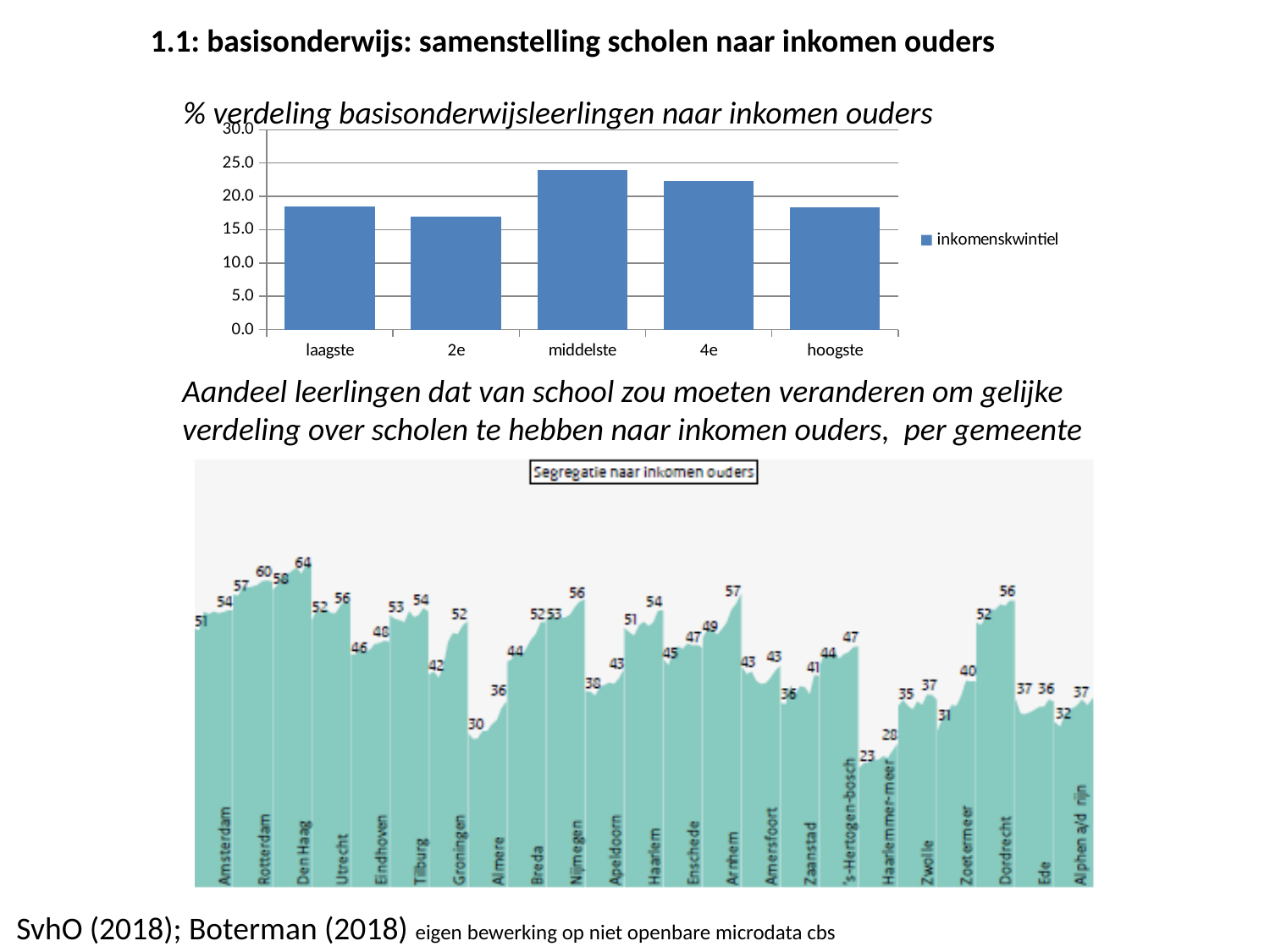
What is the legend entry of the top chart? inkomenskwintiel What kind of chart is the top chart on the slide? bar chart How many series does the legend of the top chart list? 1 In the top chart (% verdeling basisonderwijsleerlingen naar inkomen ouders), which category has the lowest value? 2e How many categories are shown on the x axis of the top chart? 5 In the top chart, which is larger, the value for middelste or the value for 4e? middelste In the top chart, is the value for 2e greater or less than 20.0? less In the top chart, is the value for middelste greater or less than 20.0? greater In the top chart, is the value for laagste greater or less than 15.0? greater In the bottom chart (Segregatie naar inkomen ouders), what is the highest value labelled? 64 In the top chart (% verdeling basisonderwijsleerlingen naar inkomen ouders), which category has the highest value? middelste